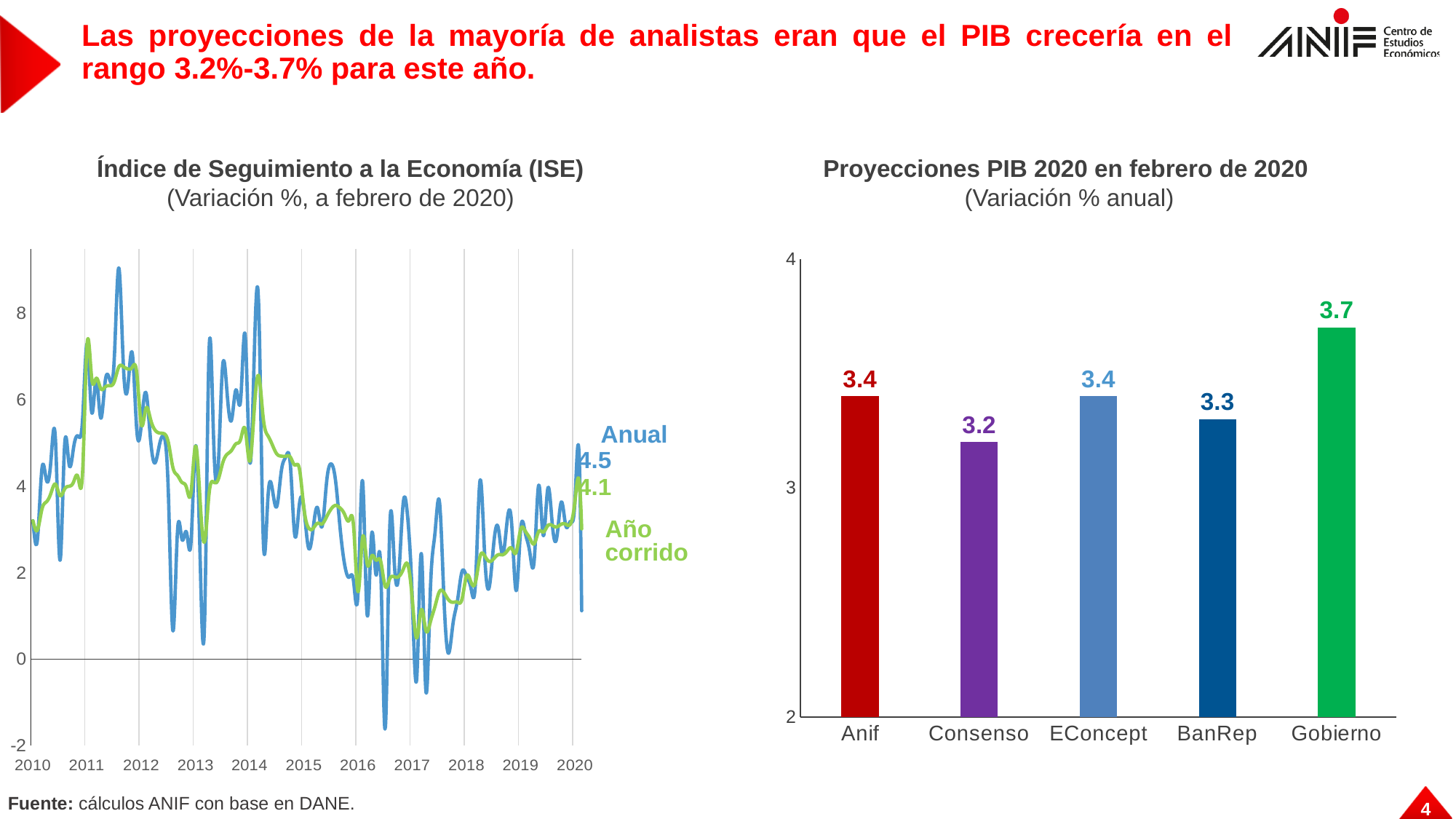
What kind of chart is the 'Índice de Seguimiento a la Economía (ISE)' chart? Line chart In the 'Proyecciones PIB 2020 en febrero de 2020' chart, which category has the lowest value? Consenso In the 'Proyecciones PIB 2020 en febrero de 2020' chart, which category has the highest value? Gobierno In the 'Proyecciones PIB 2020 en febrero de 2020' chart, what is the value for Consenso? 3.2 In the 'Proyecciones PIB 2020 en febrero de 2020' chart, what is the value for BanRep? 3.3 In the 'Índice de Seguimiento a la Economía (ISE)' chart, what is the latest labelled value of the Anual series? 4.5 In the 'Proyecciones PIB 2020 en febrero de 2020' chart, what is the value for Gobierno? 3.7 How many series are shown in the 'Índice de Seguimiento a la Economía (ISE)' chart? 2 How many categories are shown in the 'Proyecciones PIB 2020 en febrero de 2020' chart? 5 What kind of chart is the 'Proyecciones PIB 2020 en febrero de 2020' chart? Bar chart In the 'Proyecciones PIB 2020 en febrero de 2020' chart, which is larger, the value for BanRep or the value for Gobierno? Gobierno In the 'Proyecciones PIB 2020 en febrero de 2020' chart, what is the difference between the Gobierno and Consenso values? 0.5